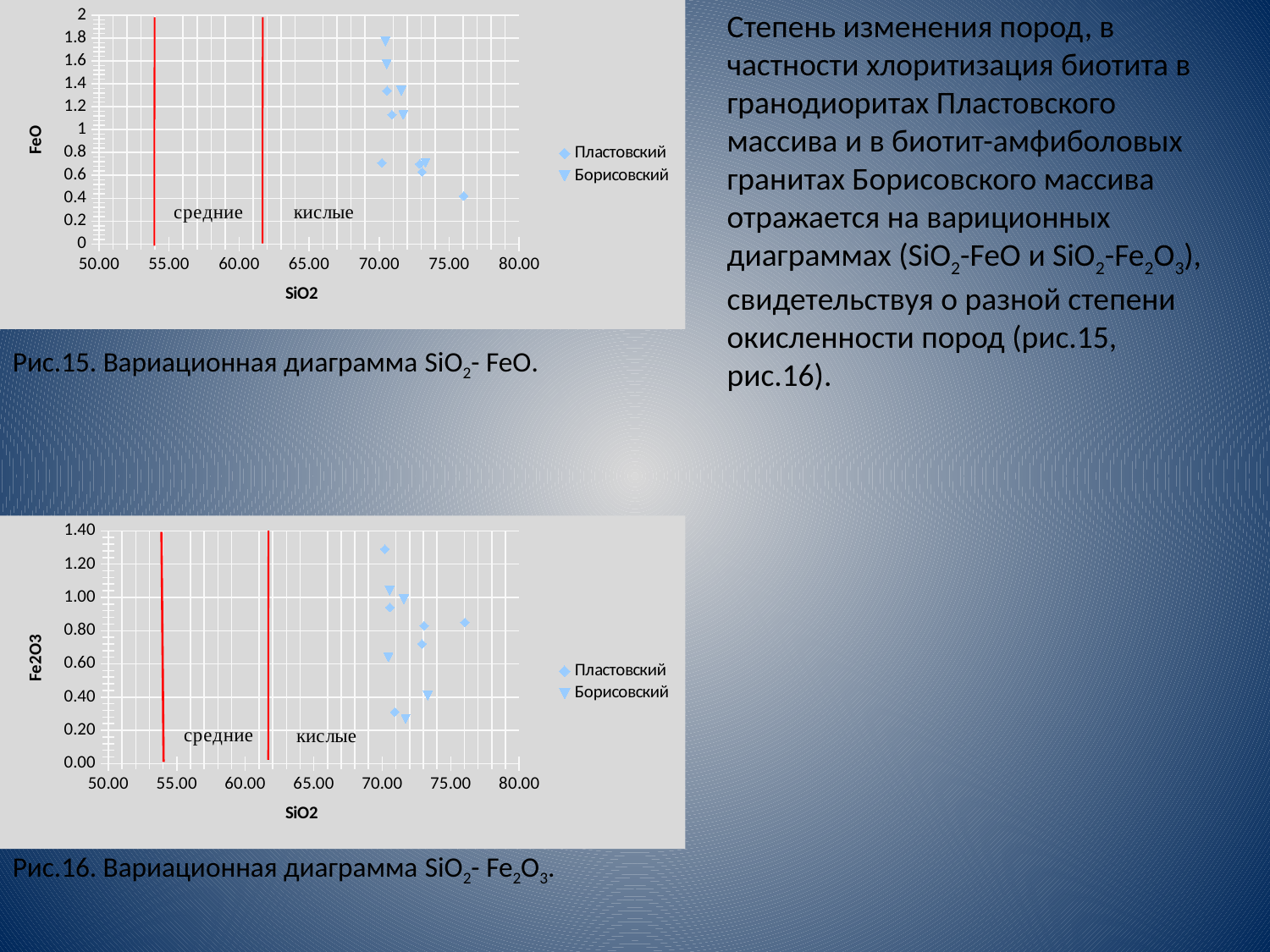
In the bottom chart (Рис.16), is the highest Пластовский point greater or less than 1.20 on the Fe2O3 axis? greater In the top chart (Рис.15), what is the label of the y axis? FeO In the bottom chart (Рис.16), which series has the point with the highest Fe2O3 value, Пластовский or Борисовский? Пластовский In the top chart (Рис.15), which series has the point with the highest FeO value, Пластовский or Борисовский? Борисовский In the top chart (Рис.15), is the Пластовский point near SiO2 = 76 greater or less than 0.6 on the FeO axis? less In the top chart (Рис.15), is the highest Борисовский point greater or less than 1.6 on the FeO axis? greater What kind of chart is the bottom chart (Рис.16)? scatter chart How many series does the legend of the top chart (Рис.15) list? 2 In the bottom chart (Рис.16), what is the label of the y axis? Fe2O3 How many series does the legend of the bottom chart (Рис.16) list? 2 What kind of chart is the top chart (Рис.15)? scatter chart